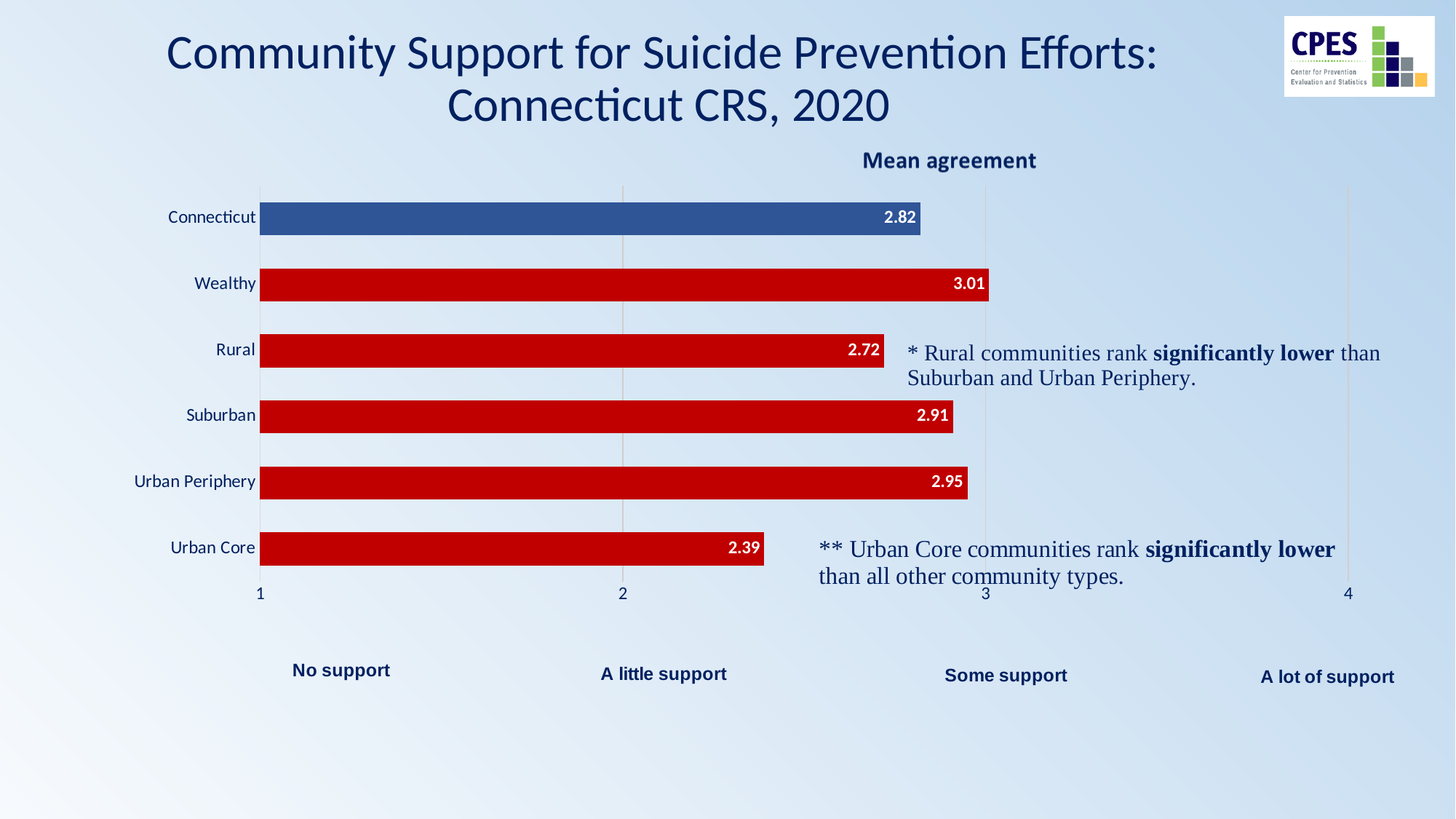
What is the mean agreement value for Urban Core communities? 2.39 Which category has the lowest mean agreement? Urban Core What is the difference between the mean agreement for Urban Periphery and Suburban? 0.04 What is the mean agreement value for Wealthy communities? 3.01 What kind of chart is shown on the slide? Bar chart Which has a higher mean agreement, Suburban or Rural? Suburban What is the mean agreement value for Connecticut? 2.82 What is the mean agreement value for Rural communities? 2.72 How many categories are shown in the chart? 6 Is the value for Wealthy greater or less than 3? greater What is the difference between the mean agreement for Wealthy and Urban Core? 0.62 Which category has the highest mean agreement? Wealthy